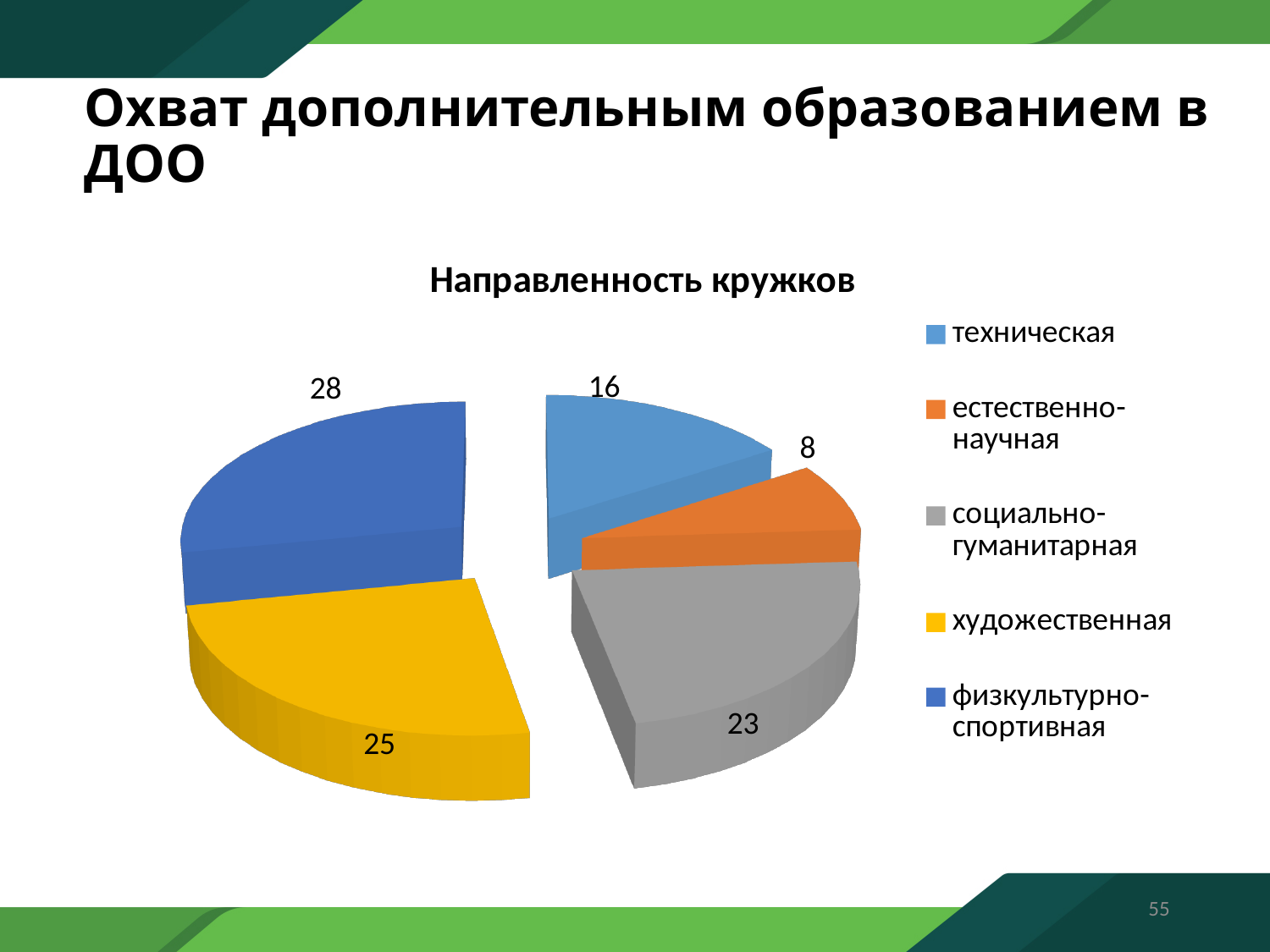
Which category has the largest slice in the pie chart? физкультурно-спортивная What is the value for техническая in the pie chart? 16 What share of the pie does художественная represent? 25% What kind of chart is shown on the slide? pie chart What is the total of all the slice values in the pie chart? 100 What is the difference between the values for физкультурно-спортивная and художественная? 3 What is the value for естественно-научная in the pie chart? 8 Which is larger, the value for техническая or the value for социально-гуманитарная? социально-гуманитарная How many slices does the pie chart have? 5 What is the value for социально-гуманитарная in the pie chart? 23 What is the title of the chart? Направленность кружков Which category has the smallest slice in the pie chart? естественно-научная